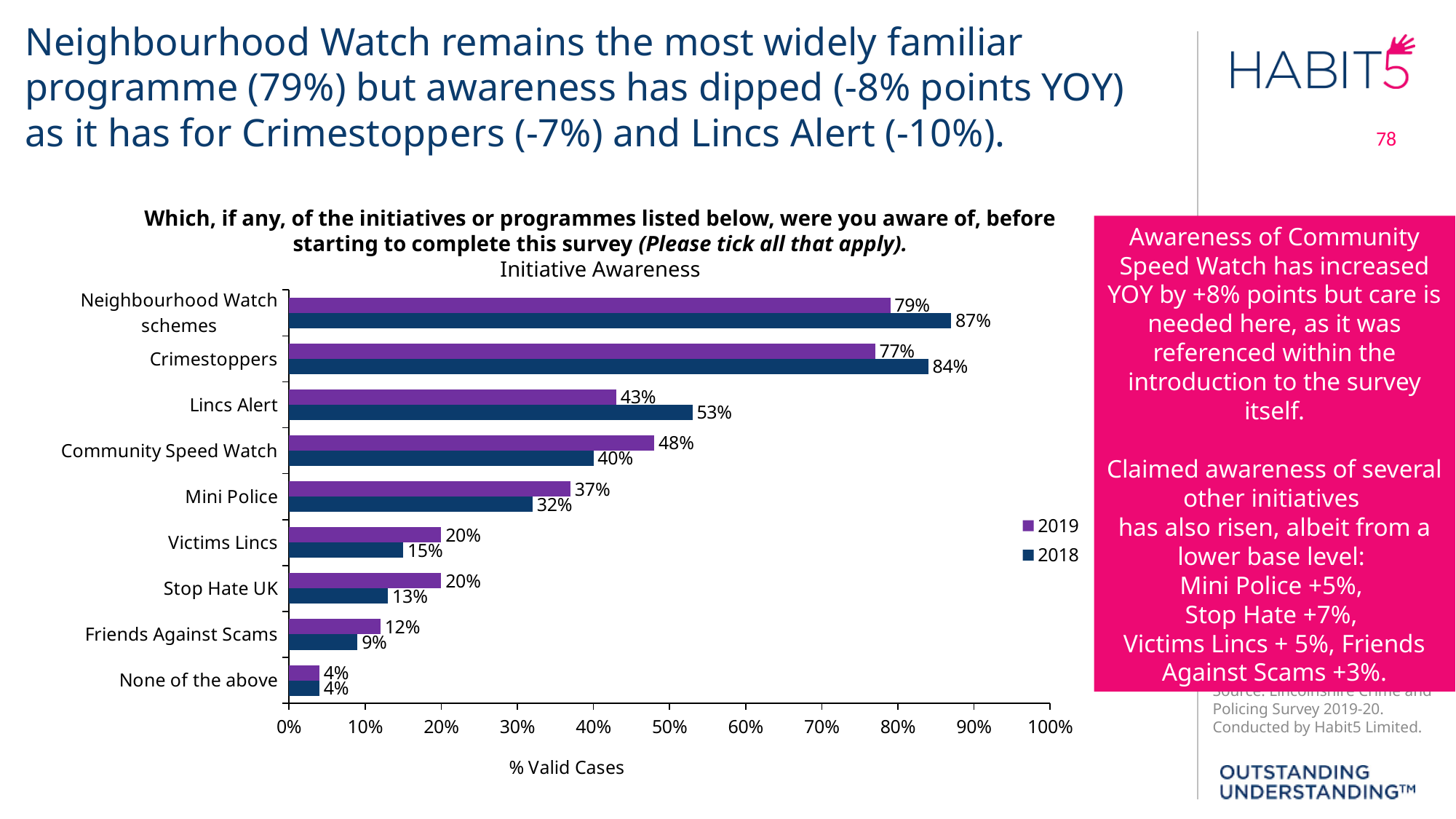
Which category has the lowest 2019 value? None of the above What is the 2019 value for Community Speed Watch? 48% How many categories are shown on the chart? 9 How many series does the legend list? 2 What kind of chart is shown on the slide? Bar chart What is the difference between the 2018 and 2019 values for Crimestoppers? 7% What is the 2019 value for Neighbourhood Watch schemes? 79% What is the label on the horizontal axis of the chart? % Valid Cases Which category has the highest 2018 value? Neighbourhood Watch schemes Which is larger for Mini Police, the 2019 value or the 2018 value? 2019 What is the 2018 value for Friends Against Scams? 9% What is the 2018 value for Lincs Alert? 53%